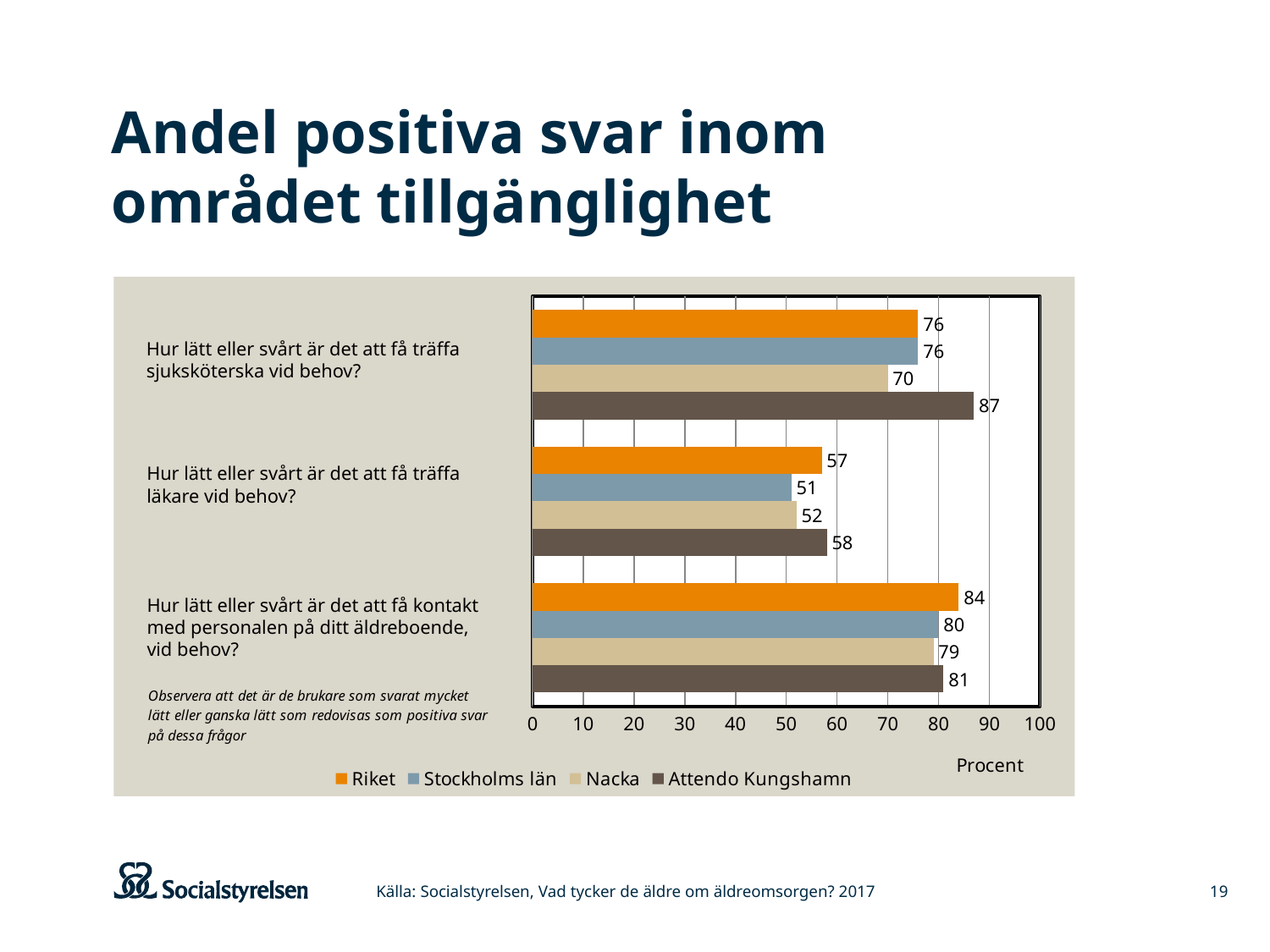
How many series does the legend list? 4 What kind of chart is shown on the slide? Bar chart How many questions (categories) are shown on the chart? 3 Is the value for Riket on the question about meeting a doctor when needed greater or less than 50? greater What is the value for Nacka on the question about meeting a doctor when needed ("Hur lätt eller svårt är det att få träffa läkare vid behov?")? 52 Which series has the lowest value on the question about meeting a doctor when needed? Stockholms län Which is larger on the question about contacting staff at the care home: Stockholms län or Nacka? Stockholms län What is the difference between Attendo Kungshamn and Nacka on the question about meeting a nurse when needed? 17 What unit is shown on the horizontal axis of the chart? Procent Which series has the highest value on the question about meeting a nurse when needed? Attendo Kungshamn What is the value for Riket on the question about contacting staff at the care home ("Hur lätt eller svårt är det att få kontakt med personalen på ditt äldreboende, vid behov?")? 84 What is the value for Attendo Kungshamn on the question about meeting a nurse when needed ("Hur lätt eller svårt är det att få träffa sjuksköterska vid behov?")? 87